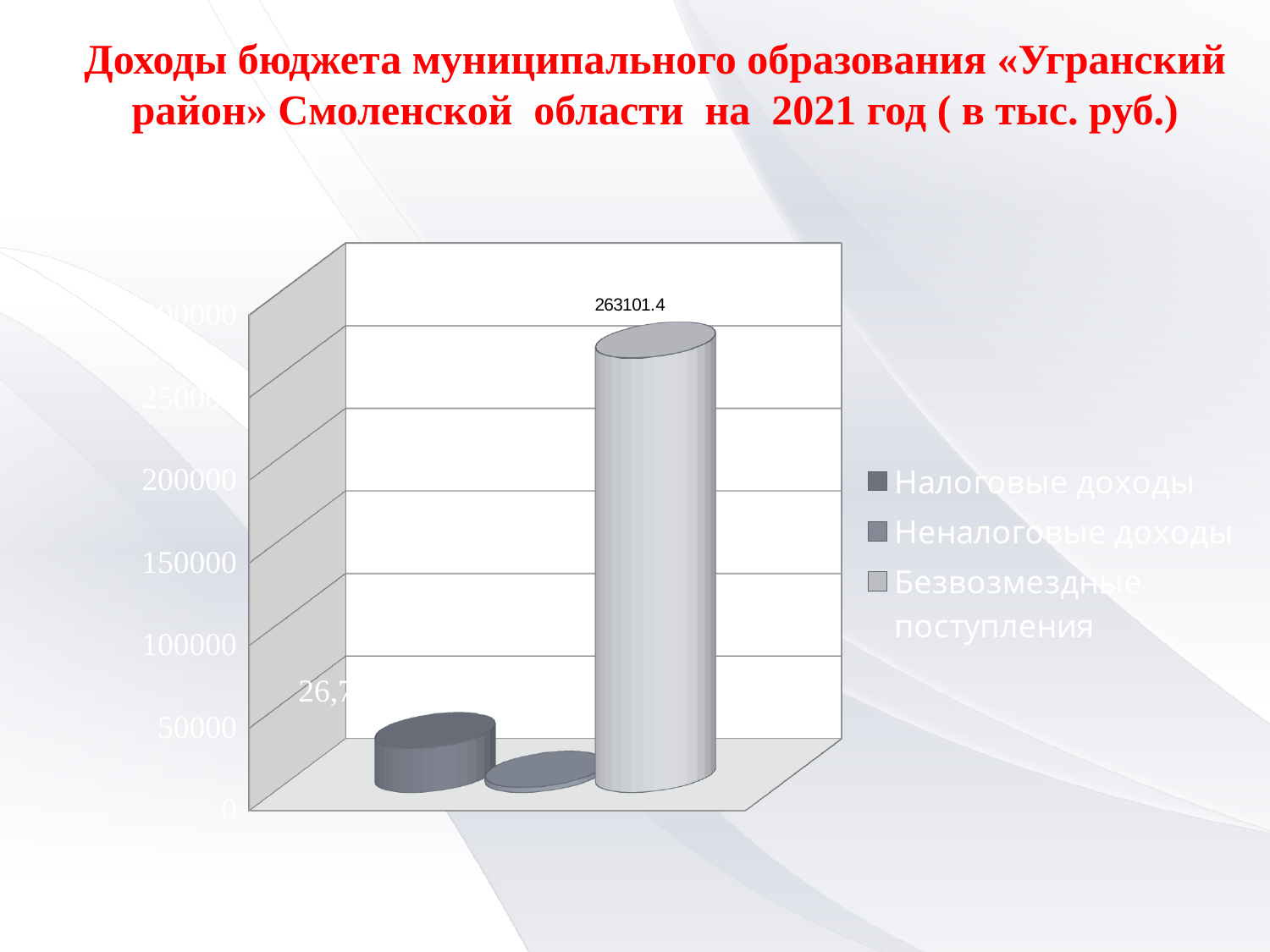
What is the value shown for Безвозмездные поступления? 263101.4 Which series has the lowest value? Неналоговые доходы What year does the slide title say the budget revenues are for? 2021 Is the value for Неналоговые доходы greater or less than 50000? less Which series has the highest value? Безвозмездные поступления What kind of chart is shown on the slide? bar chart In what units does the title say the values are given? тыс. руб. Which is larger, Налоговые доходы or Неналоговые доходы? Налоговые доходы Is the value for Безвозмездные поступления greater or less than 250000? greater How many bars are plotted on the chart? 3 How many series does the legend list? 3 Is the value for Налоговые доходы greater or less than 50000? less